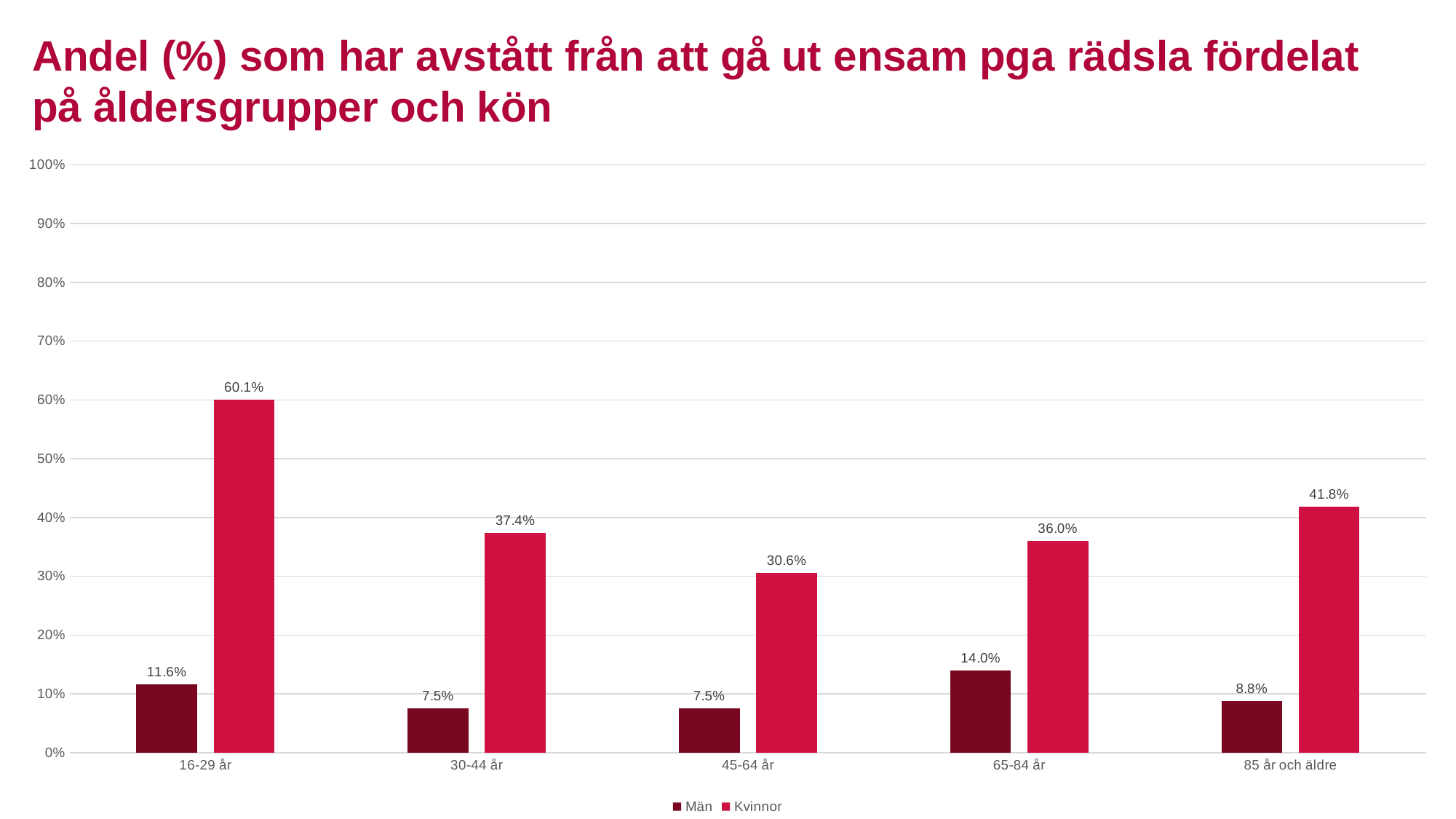
What kind of chart is shown on the slide? Bar chart How many age groups are shown on the x axis? 5 What is the difference between the Kvinnor and Män values in the 16-29 år age group? 48.5% What is the value for Män in the 65-84 år age group? 14.0% Which age group has the highest value for Män? 65-84 år Which age group has the lowest value for Kvinnor? 45-64 år Which age group has the highest value for Kvinnor? 16-29 år What is the value for Kvinnor in the 85 år och äldre age group? 41.8% How many series does the legend list? 2 Which is larger: the Kvinnor value for 30-44 år or the Kvinnor value for 65-84 år? 30-44 år What is the value for Kvinnor in the 16-29 år age group? 60.1% Which series is shown in the darker colour in the legend? Män